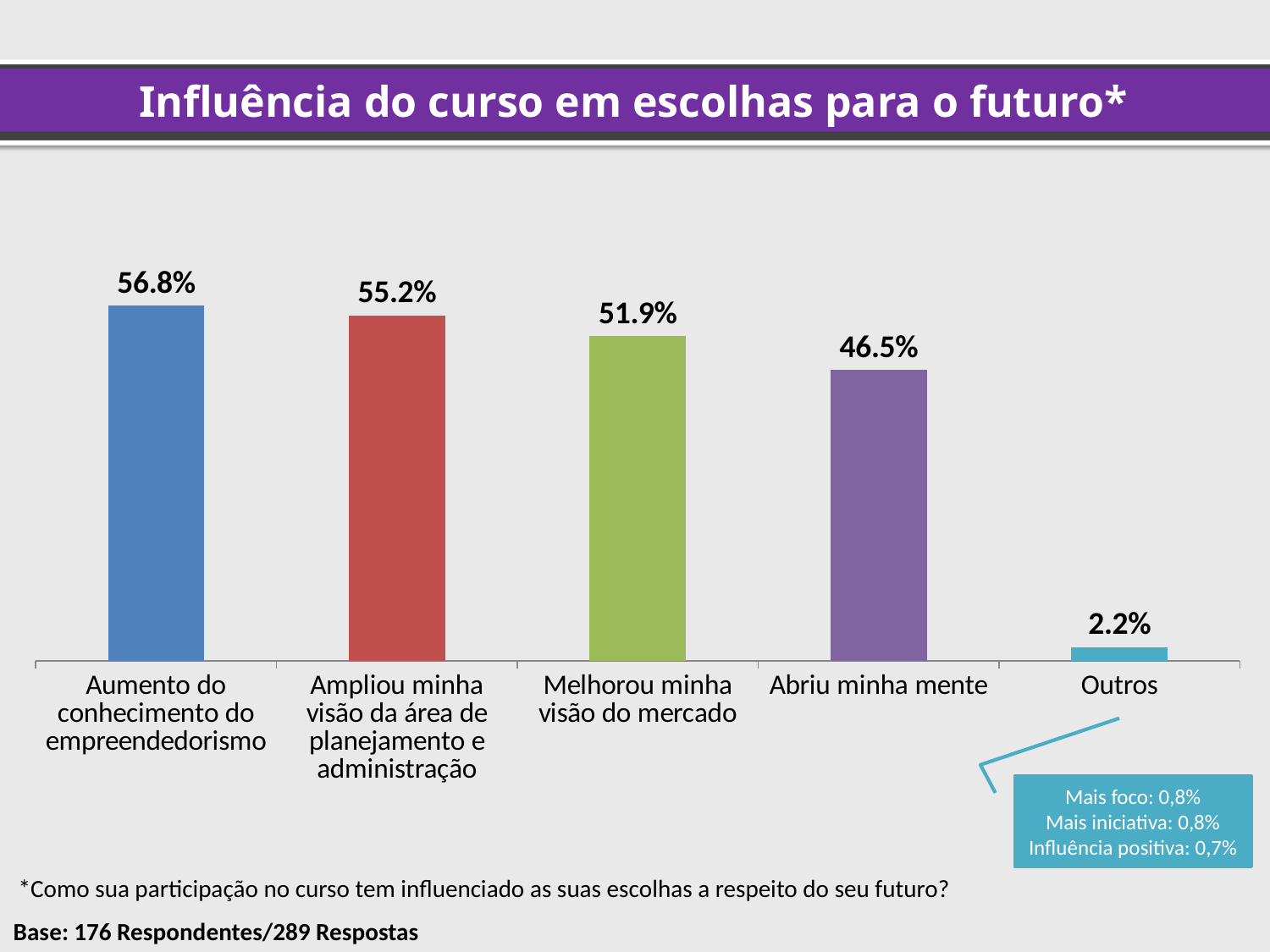
What kind of chart is shown on the slide? Bar chart What is the value for "Melhorou minha visão do mercado"? 51.9% What is the title of the chart? Influência do curso em escolhas para o futuro* What is the value for "Outros"? 2.2% What is the difference between "Aumento do conhecimento do empreendedorismo" and "Ampliou minha visão da área de planejamento e administração"? 1.6% How many categories are shown in the chart? 5 Which category has the highest value? Aumento do conhecimento do empreendedorismo What is the value for "Abriu minha mente"? 46.5% Which is larger, "Ampliou minha visão da área de planejamento e administração" or "Melhorou minha visão do mercado"? Ampliou minha visão da área de planejamento e administração What is the difference between "Melhorou minha visão do mercado" and "Abriu minha mente"? 5.4% What is the value for "Aumento do conhecimento do empreendedorismo"? 56.8% Which category has the lowest value? Outros